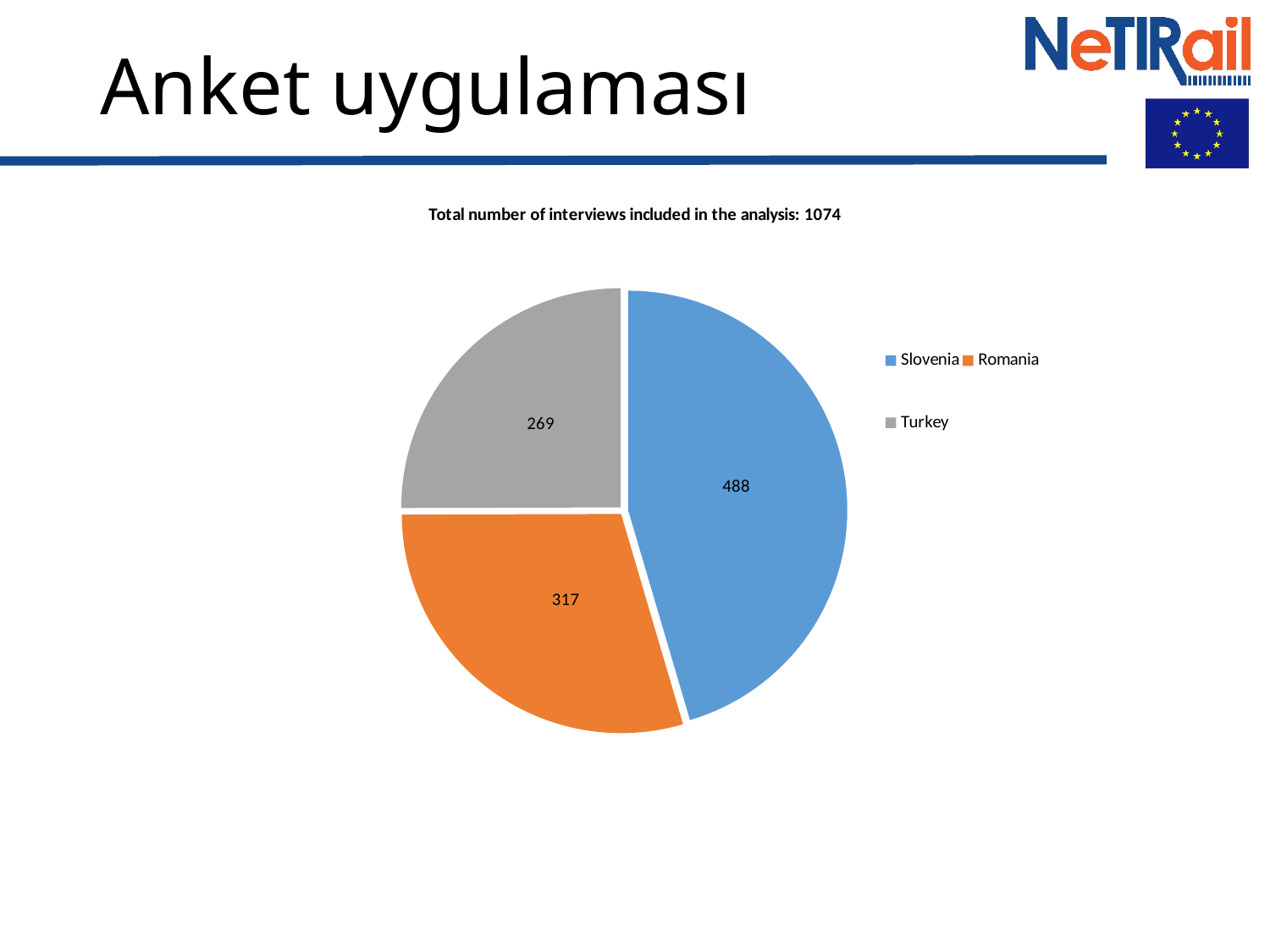
How many interviews does the pie chart show for Turkey? 269 Which has more interviews, Romania or Turkey? Romania What kind of chart is shown on the slide? pie chart What is the difference between the number of interviews for Slovenia and Romania? 171 Which country has the largest slice of the pie chart? Slovenia What is the title of the chart? Total number of interviews included in the analysis: 1074 What is the difference between the number of interviews for Romania and Turkey? 48 What colour is the Turkey slice in the pie chart? grey How many countries are shown in the pie chart? 3 How many interviews does the pie chart show for Romania? 317 Which country has the smallest slice of the pie chart? Turkey How many interviews does the pie chart show for Slovenia? 488